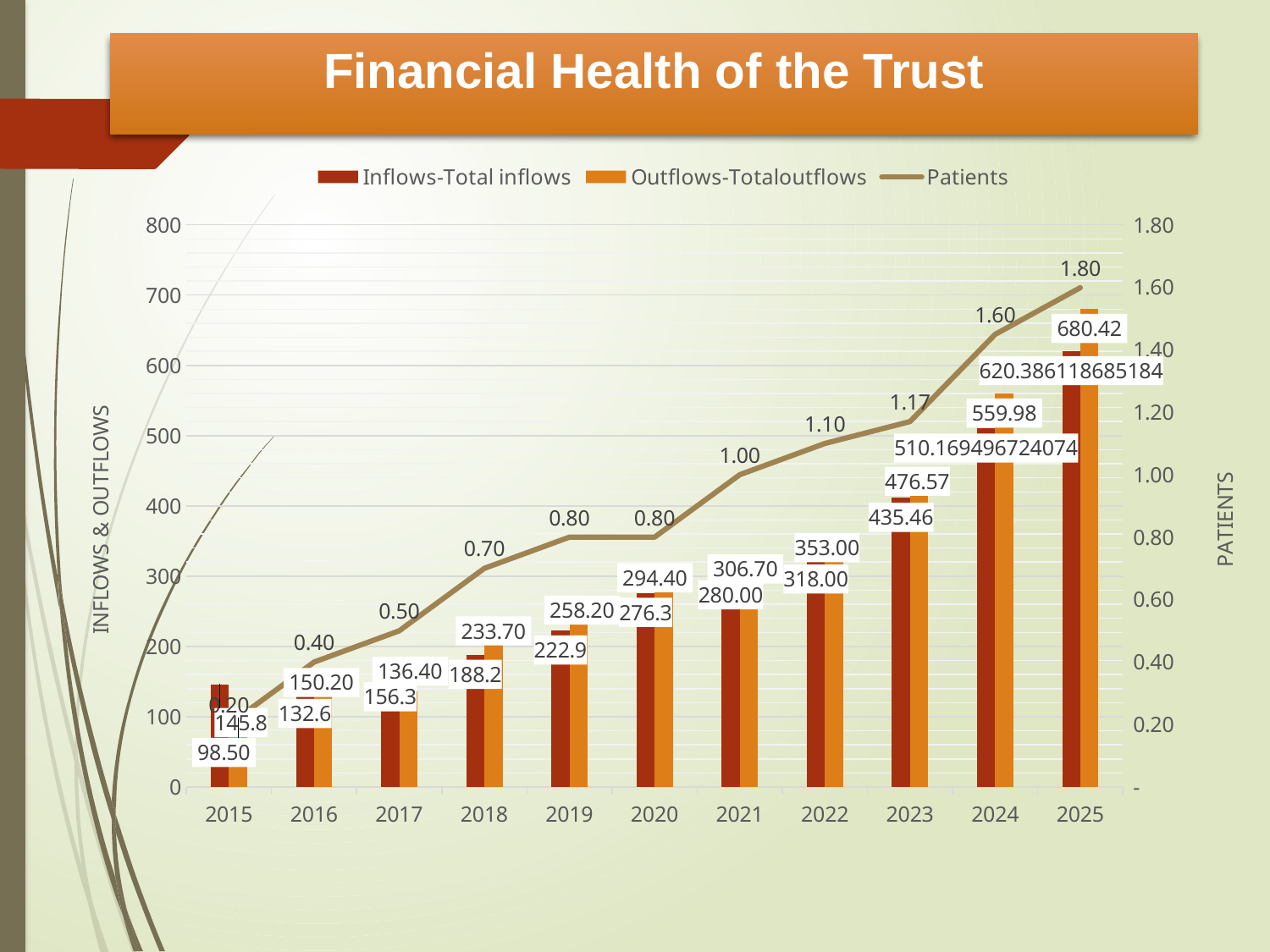
What is the Patients value for 2015? 0.20 What is the title of the chart? Financial Health of the Trust How many series does the legend list? 3 Which year has the lowest Patients value? 2015 What is the Patients value for 2023? 1.17 What is the difference between the Patients values for 2025 and 2024? 0.20 Which year has the larger Patients value, 2021 or 2022? 2022 Do the Patients values rise or fall from 2015 to 2025? Rise How many years are shown on the x axis? 11 Which year has the highest Patients value? 2025 What is the Patients value for 2025? 1.80 What kind of chart is shown on the slide? A bar chart with a line